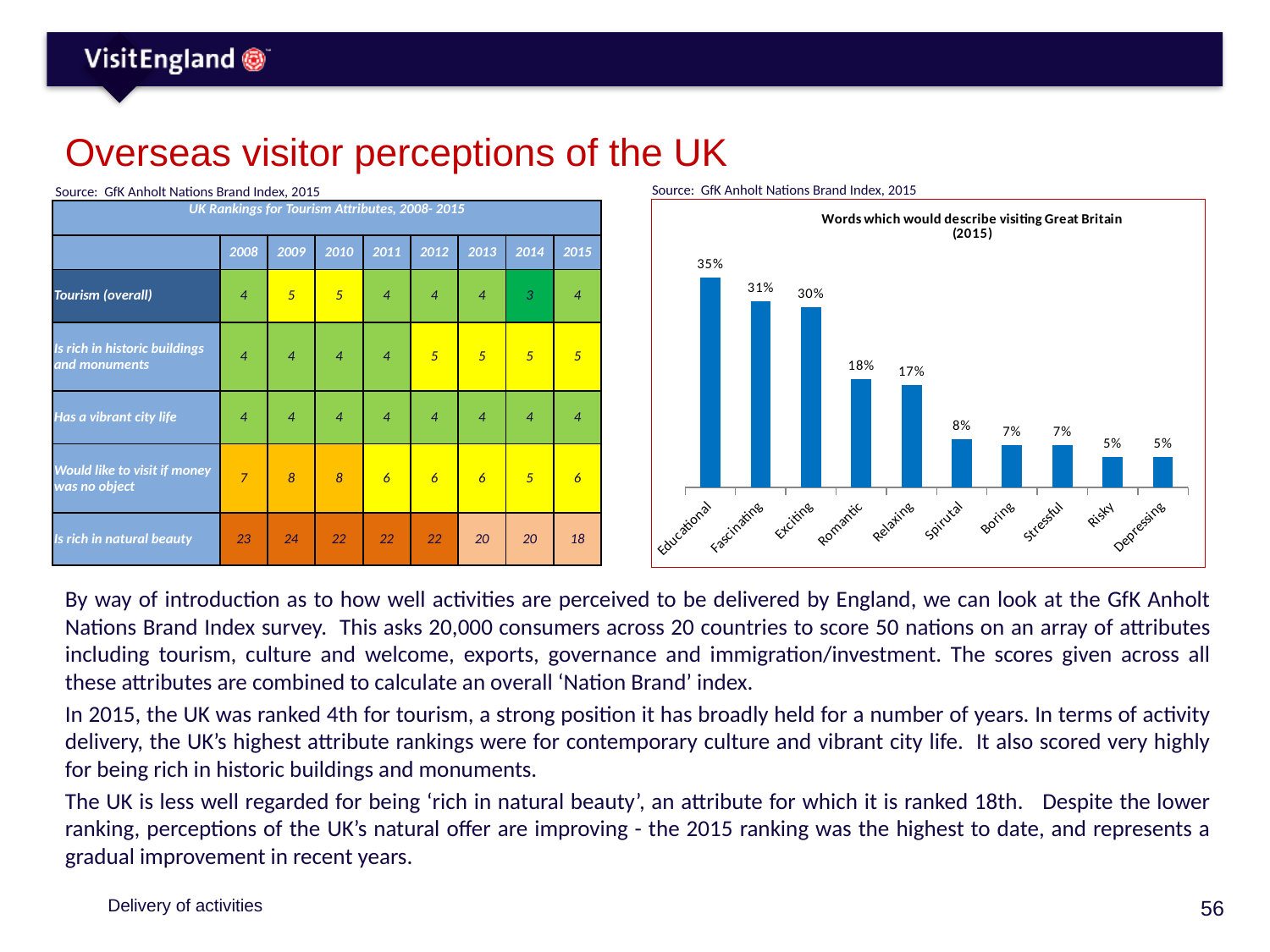
How many words (categories) are shown in the bar chart? 10 Which word has the highest value in the bar chart? Educational Which has a larger value, 'Exciting' or 'Relaxing'? Exciting What is the title of the bar chart? Words which would describe visiting Great Britain (2015) What kind of chart is shown on the slide? bar chart What is the difference between the values for 'Educational' and 'Fascinating'? 4% What percentage of respondents said 'Educational' would describe visiting Great Britain? 35% Do the values in the bar chart rise or fall from left to right? fall What is the value shown for 'Boring' in the bar chart? 7% What is the difference between the values for 'Romantic' and 'Spirutal'? 10% What is the value shown for 'Depressing' in the bar chart? 5% What is the value shown for 'Romantic' in the bar chart? 18%